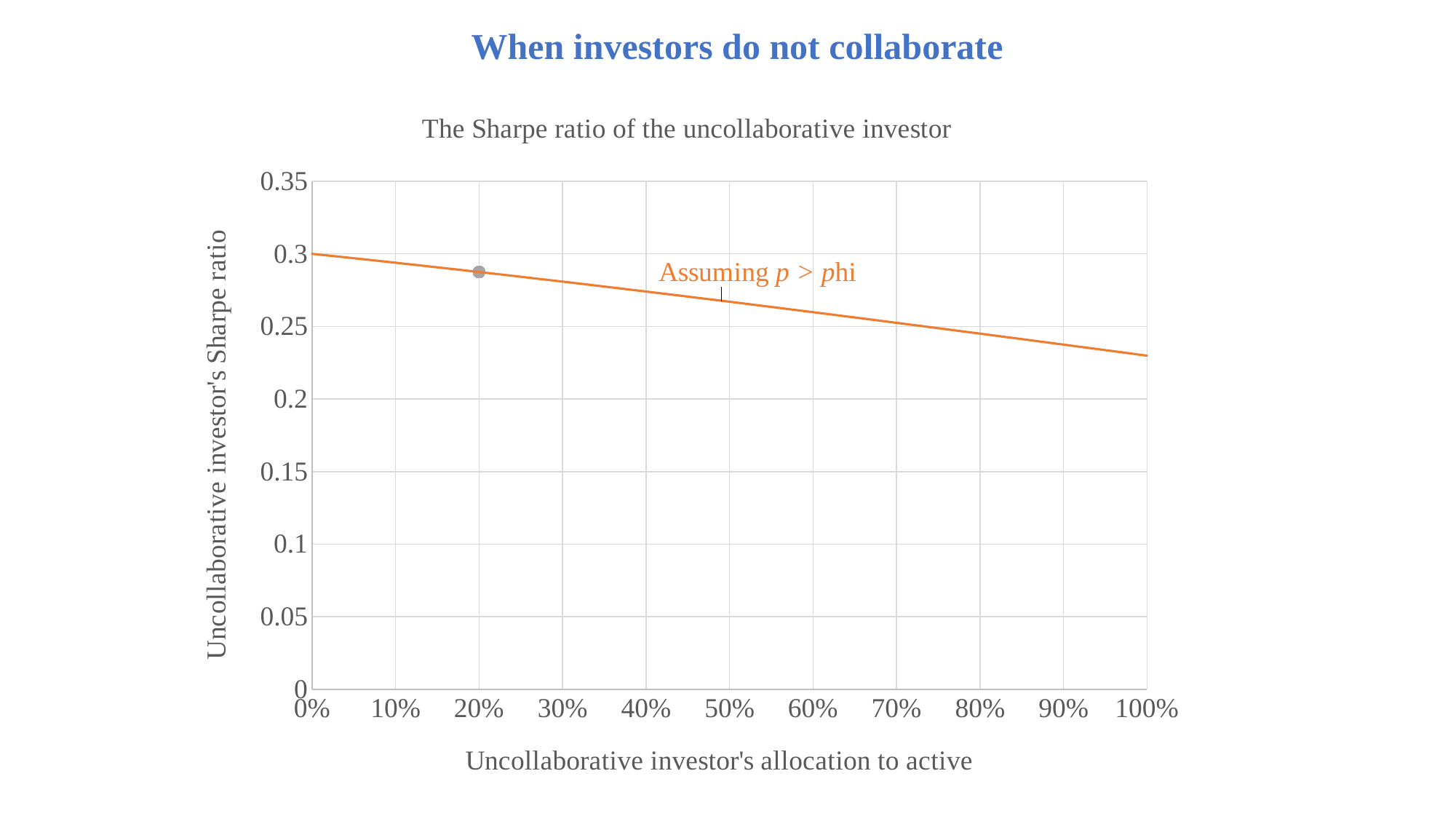
Is the Sharpe ratio at a 100% allocation to active greater or less than 0.2? greater Is the Sharpe ratio at a 50% allocation to active greater or less than 0.25? greater Is the Sharpe ratio at a 100% allocation to active greater or less than 0.25? less What is the uncollaborative investor's Sharpe ratio at a 0% allocation to active? 0.3 What is the label of the x axis? Uncollaborative investor's allocation to active Which allocation to active gives the higher Sharpe ratio, 0% or 100%? 0% At which allocation to active is the uncollaborative investor's Sharpe ratio highest? 0% What is the title of the chart? The Sharpe ratio of the uncollaborative investor Does the uncollaborative investor's Sharpe ratio rise or fall as the allocation to active increases from 0% to 100%? fall What kind of chart is shown on the slide? line chart